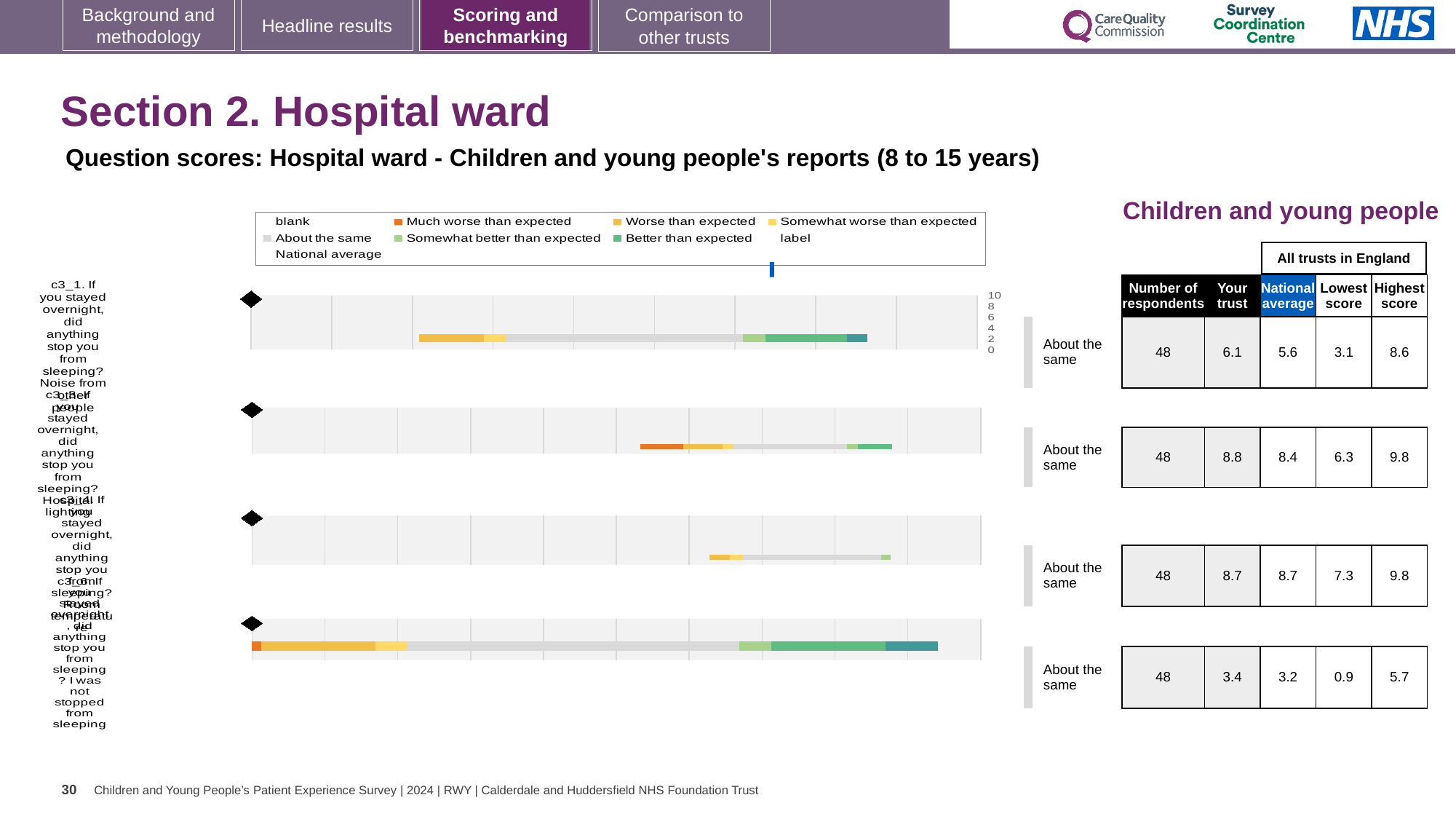
How many respondents are listed for each bar in the table beside the chart? 48 For the first bar, which is larger: the 'Your trust' score or the national average? Your trust How many entries does the chart legend list? 9 Which bar has the lowest 'Your trust' score in the table beside the chart? the fourth bar (3.4) Which bar has the highest 'Your trust' score in the table beside the chart? the second bar (8.8) In the table beside the chart, what is the 'Your trust' score for the first bar (c3_1, noise from other people)? 6.1 What kind of chart is shown on the slide? bar chart For the second bar, what is the difference between the highest score (9.8) and the lowest score (6.3)? 3.5 What colour does the legend use for 'Better than expected'? green In the table beside the chart, what is the national average for the fourth (bottom) bar? 3.2 What colour does the legend use for 'Much worse than expected'? orange How many horizontal bars (question rows) does the chart contain? 4